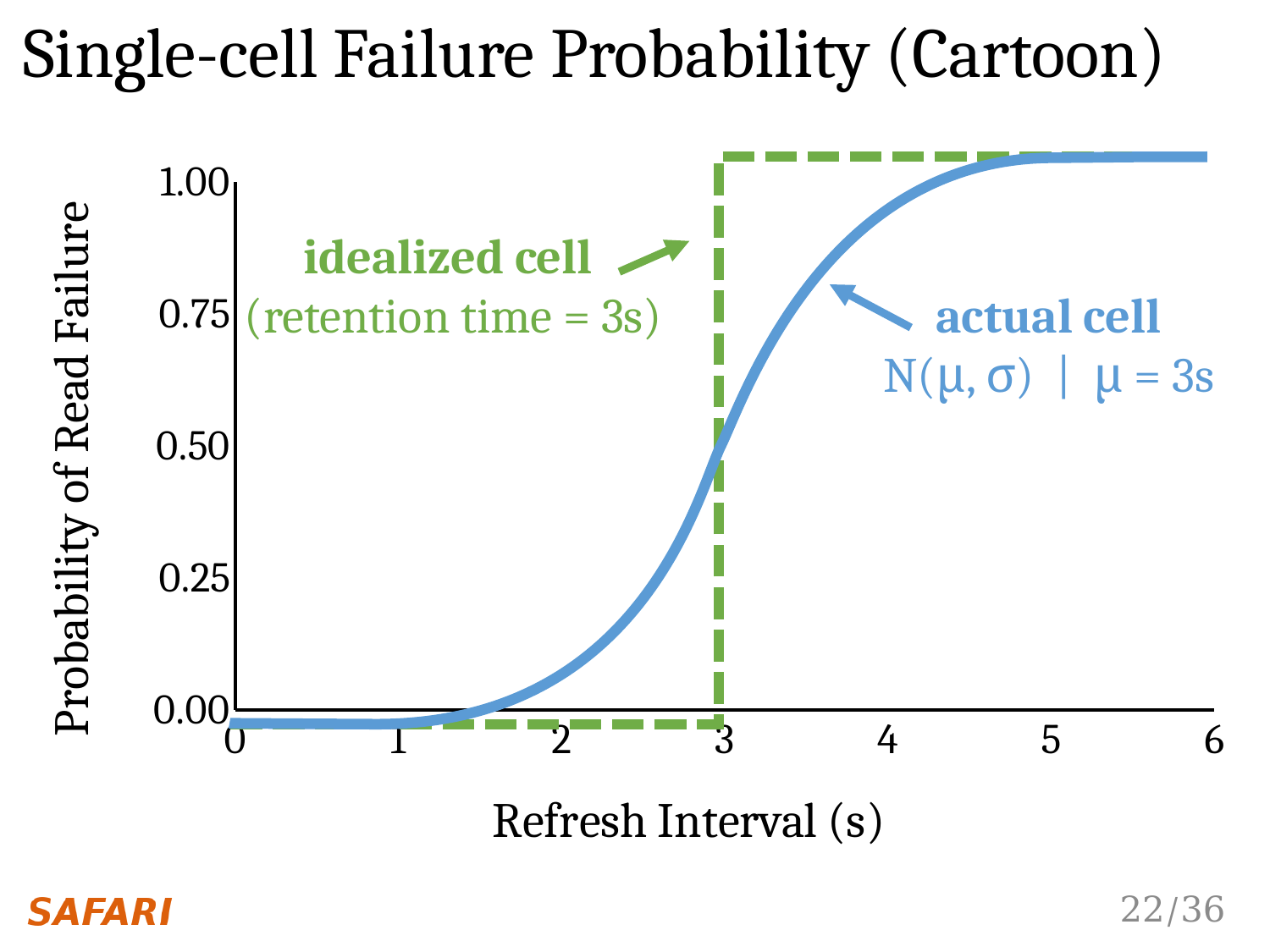
What is the title of the chart on the slide? Single-cell Failure Probability (Cartoon) How many curves (series) are plotted on the chart? 2 Is the probability of read failure for the actual cell at a refresh interval of 1 s greater or less than 0.25? less At a refresh interval of 2 s, which curve shows the higher probability of read failure, the idealized cell or the actual cell? actual cell What is the label of the x axis? Refresh Interval (s) What value of μ is given for the actual cell? 3s Is the probability of read failure for the actual cell at a refresh interval of 4 s greater or less than 0.75? greater At a refresh interval of 4 s, which curve shows the higher probability of read failure, the idealized cell or the actual cell? idealized cell What retention time is given for the idealized cell? 3s Is the probability of read failure for the actual cell at a refresh interval of 2 s greater or less than 0.25? less Does the probability of read failure for the actual cell rise or fall as the refresh interval increases? rise What kind of chart is shown on the slide? line chart